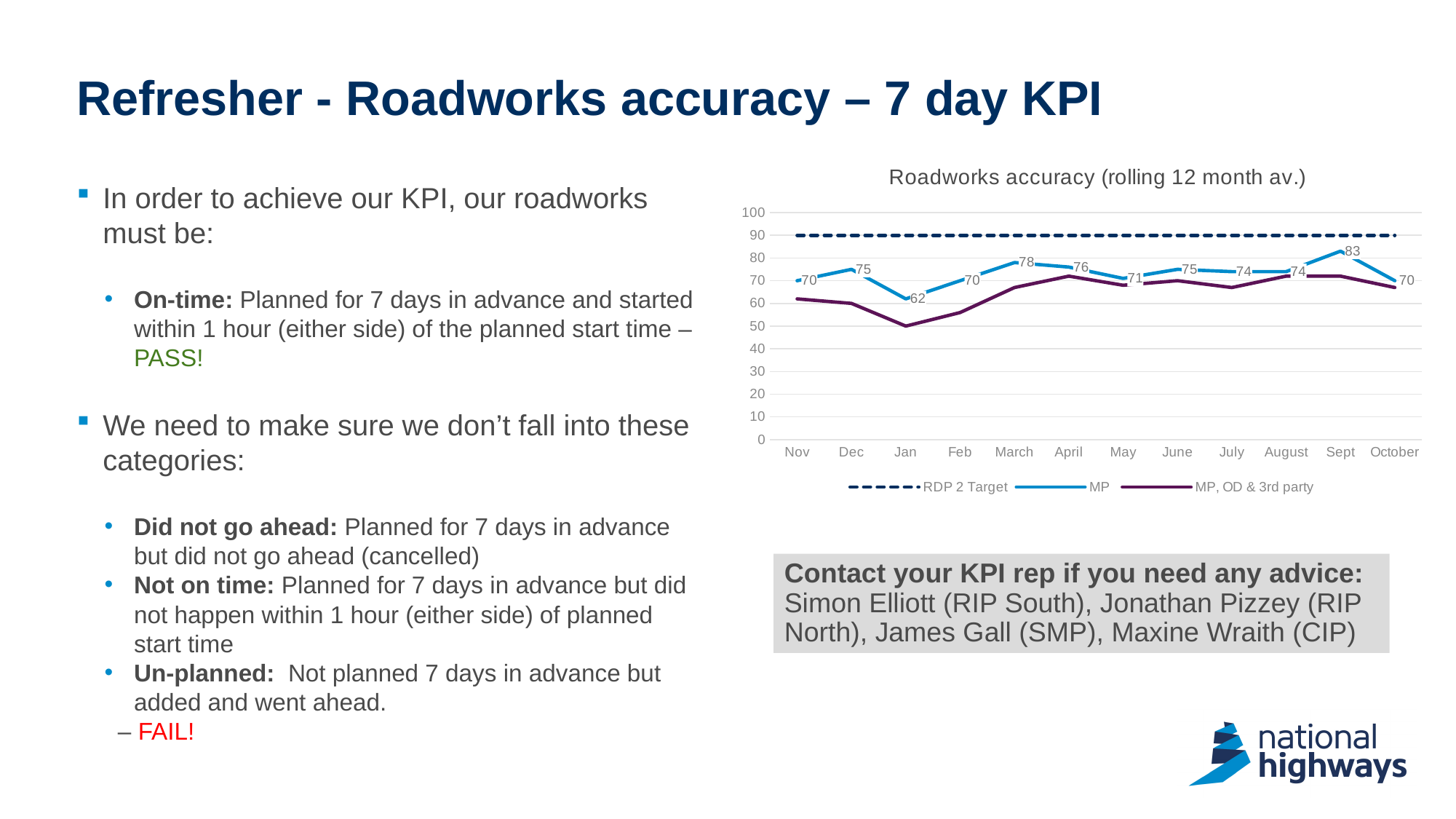
How many series does the chart legend list? 3 In which month is the MP series lowest? Jan What is the MP value for March? 78 What is the MP value for Jan? 62 What is the title of the chart? Roadworks accuracy (rolling 12 month av.) How many months are shown along the x axis of the chart? 12 What is the MP value for Sept? 83 What kind of chart is shown on the slide? line chart In which month is the MP series highest? Sept Which is larger, the MP value for Dec or for Feb? Dec Is the value for MP, OD & 3rd party in Jan greater or less than 60? less What is the difference between the MP values for Sept and Jan? 21